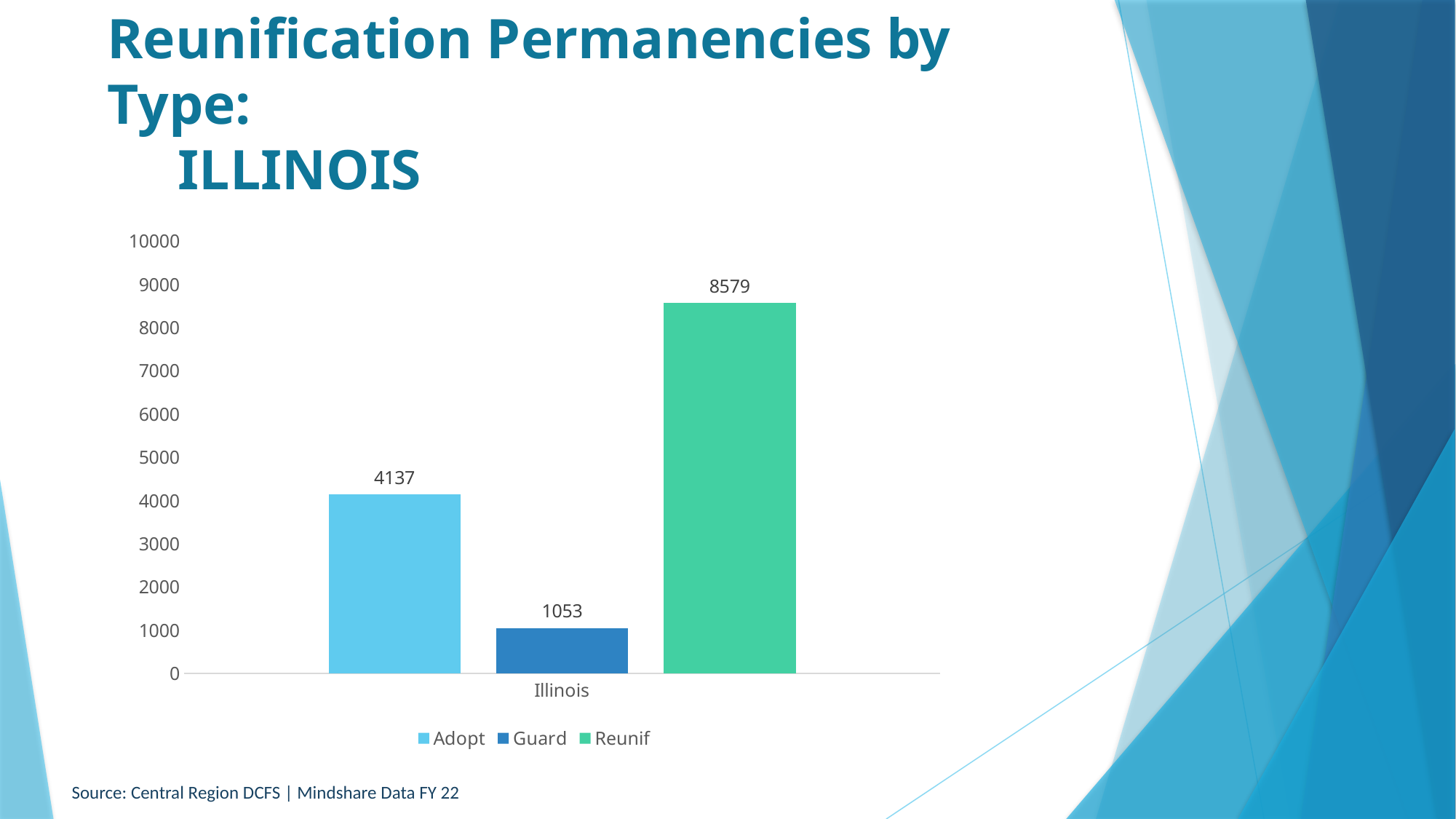
What is the category label on the x axis? Illinois Is the value for Reunif greater or less than 8000? greater Which series has the lowest value? Guard What is the difference between the Adopt and Guard values? 3084 Which series has the highest value? Reunif How many series does the legend list? 3 Which is larger, Adopt or Guard? Adopt What is the difference between the Reunif and Adopt values? 4442 What kind of chart is shown on the slide? bar chart What is the value for Reunif in Illinois? 8579 What is the value for Guard in Illinois? 1053 What is the value for Adopt in Illinois? 4137